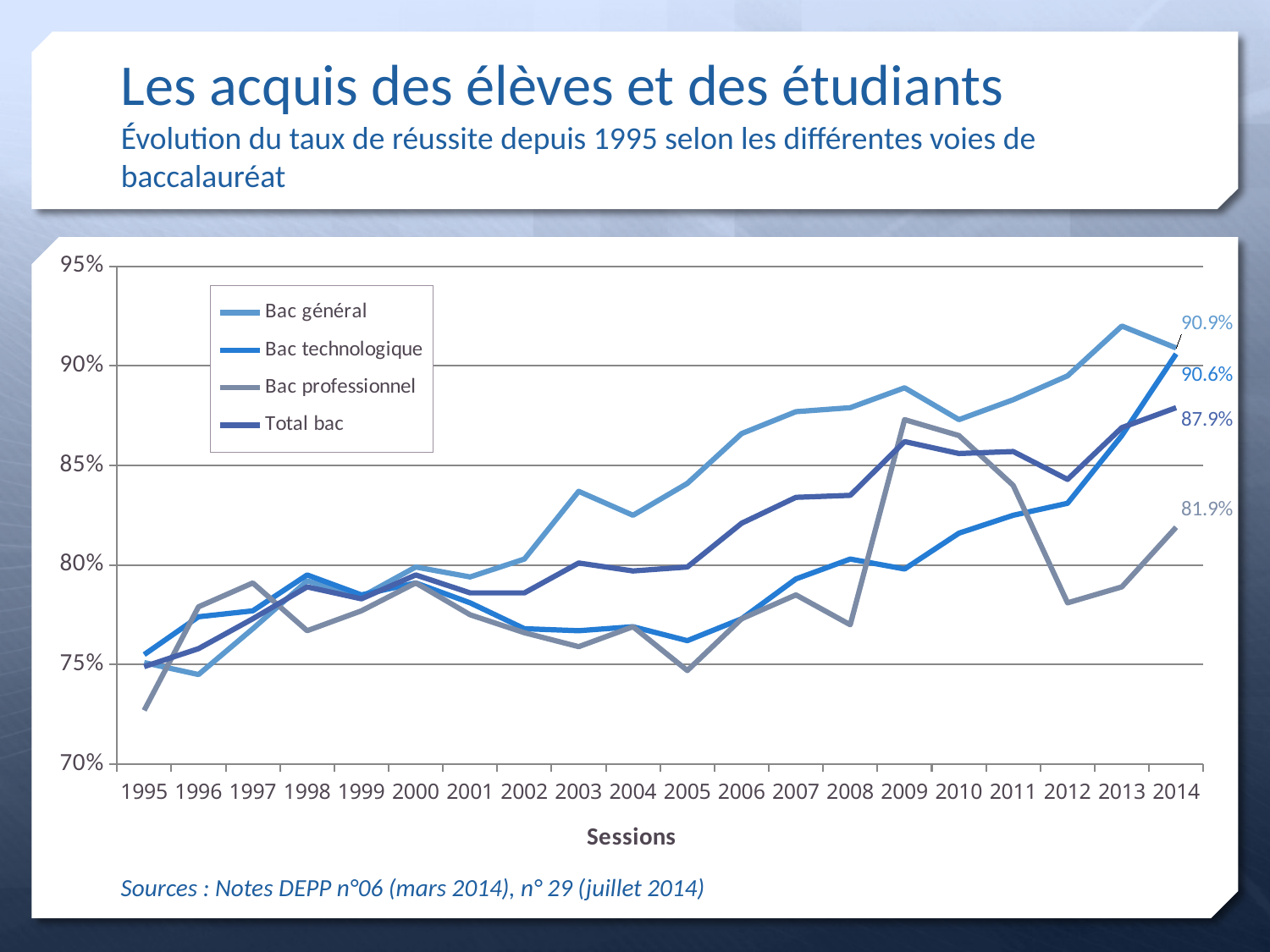
What is the value for Bac professionnel in 2014? 81.9% Is the value for Bac professionnel in 1995 greater or less than 75%? less How many series does the legend list? 4 Is the value for Bac général in 2013 greater or less than 90%? greater How many sessions (years) are plotted along the x axis? 20 What is the value for Bac général in 2014? 90.9% What is the value for Total bac in 2014? 87.9% What is the difference between Bac général and Bac professionnel in 2014? 9.0 percentage points What type of chart is shown on the slide? Line chart Which series has the lowest value in 2014? Bac professionnel What is the title of the x axis? Sessions What is the value for Bac technologique in 2014? 90.6%